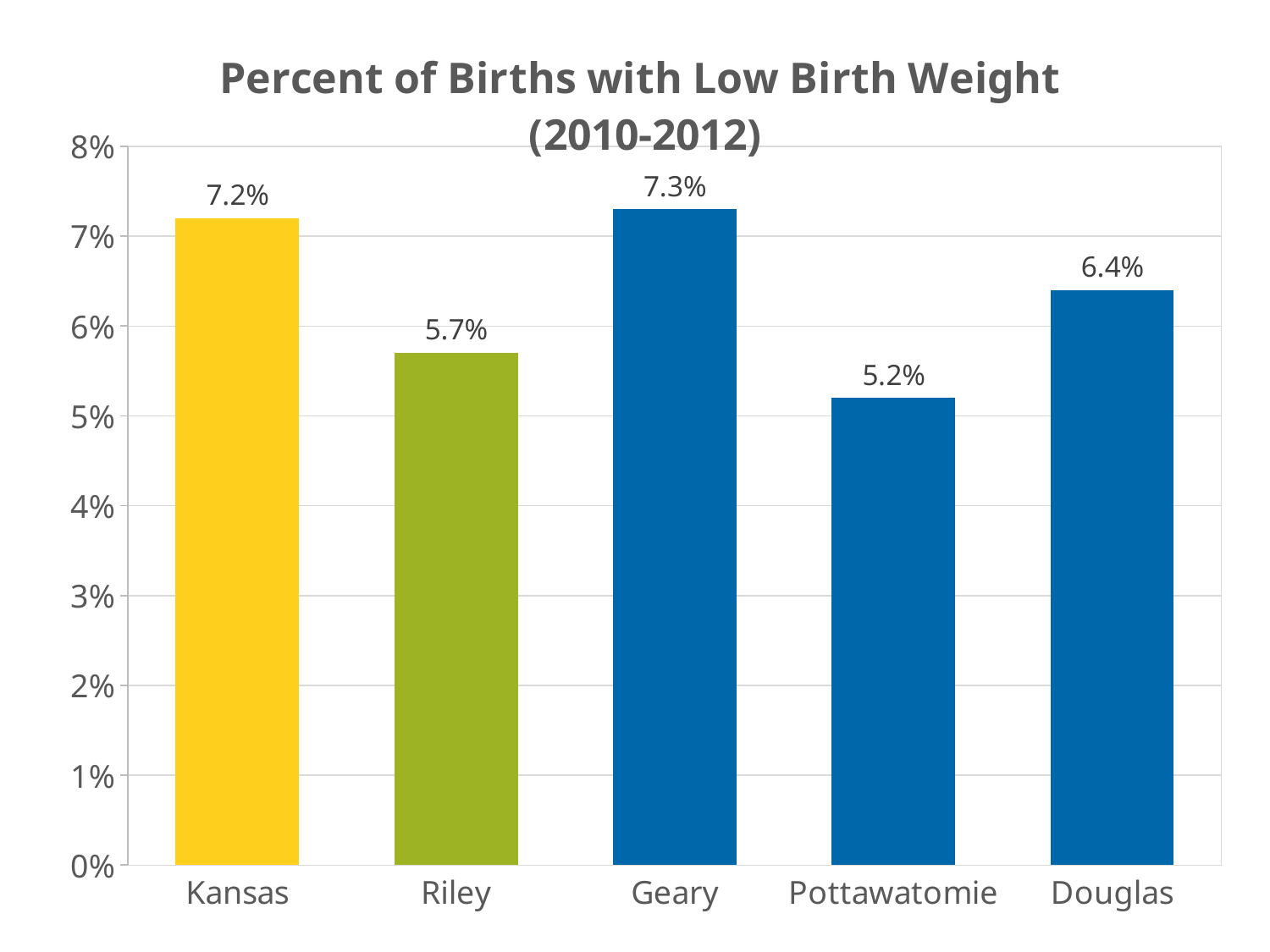
Which category has the lowest percent of births with low birth weight? Pottawatomie What is the percent of births with low birth weight for Riley? 5.7% What is the percent of births with low birth weight for Kansas? 7.2% What kind of chart is shown on the slide? Bar chart Which has a higher percent of births with low birth weight, Riley or Douglas? Douglas What is the percent of births with low birth weight for Douglas? 6.4% What is the difference between the values for Kansas and Riley? 1.5% What is the difference between the values for Geary and Pottawatomie? 2.1% What is the percent of births with low birth weight for Pottawatomie? 5.2% What is the title of the chart? Percent of Births with Low Birth Weight (2010-2012) Which category has the highest percent of births with low birth weight? Geary How many categories are shown on the chart? 5